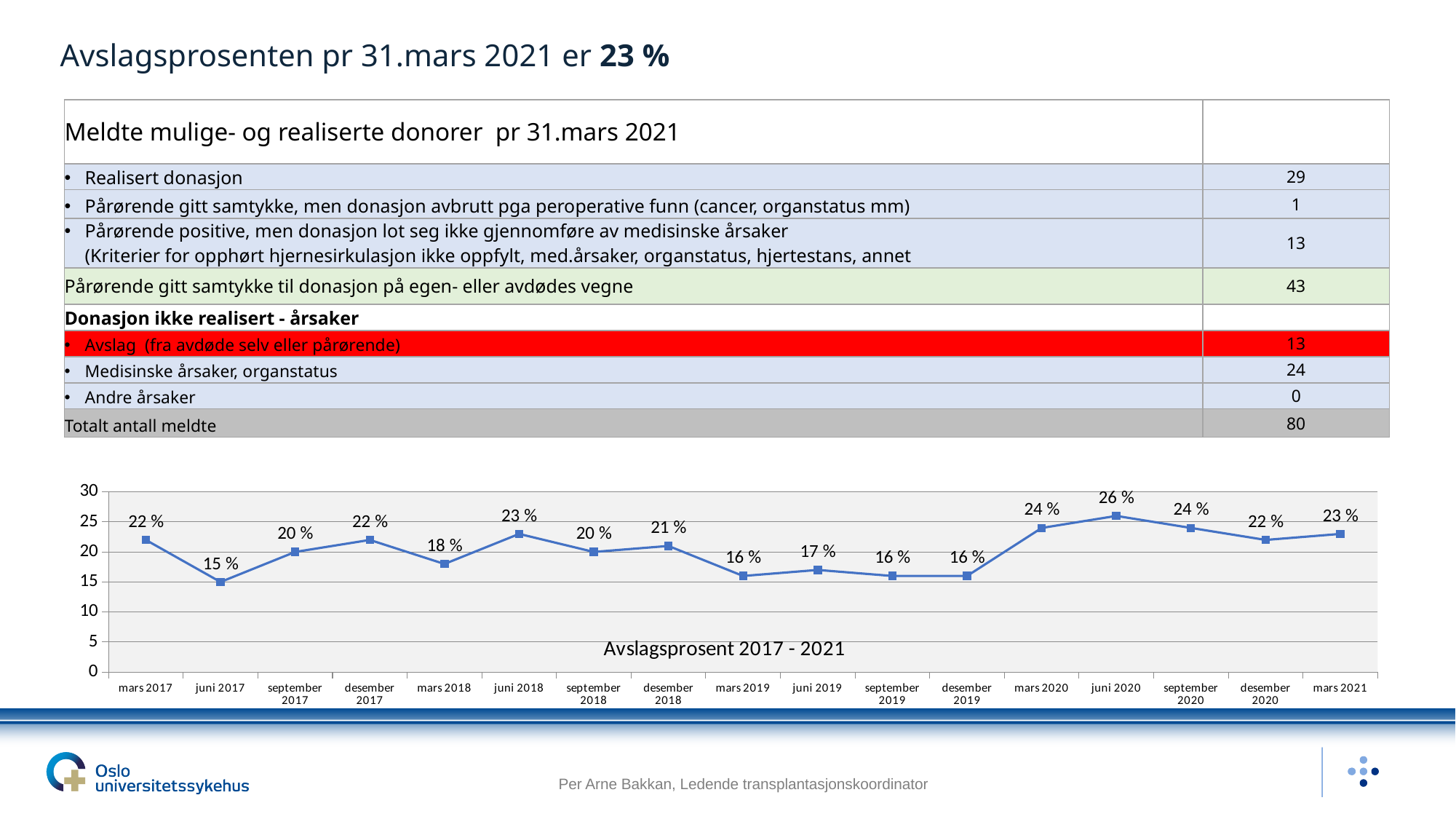
What kind of chart is the Avslagsprosent 2017 - 2021 chart? line chart What is the difference between the values for mars 2020 and mars 2019 in the Avslagsprosent 2017 - 2021 chart? 8 % What is the difference between the values for juni 2020 and juni 2017 in the Avslagsprosent 2017 - 2021 chart? 11 % What is the value for desember 2018 in the Avslagsprosent 2017 - 2021 chart? 21 % Is the value for september 2019 in the Avslagsprosent 2017 - 2021 chart greater or less than 20? less What is the value for juni 2020 in the Avslagsprosent 2017 - 2021 chart? 26 % Do the values in the Avslagsprosent 2017 - 2021 chart rise or fall from desember 2019 to juni 2020? rise What is the value for mars 2021 in the Avslagsprosent 2017 - 2021 chart? 23 % Which period has the highest value in the Avslagsprosent 2017 - 2021 chart? juni 2020 Which is larger in the Avslagsprosent 2017 - 2021 chart, the value for mars 2018 or the value for juni 2018? juni 2018 Which period has the lowest value in the Avslagsprosent 2017 - 2021 chart? juni 2017 How many data points are plotted in the Avslagsprosent 2017 - 2021 chart? 17